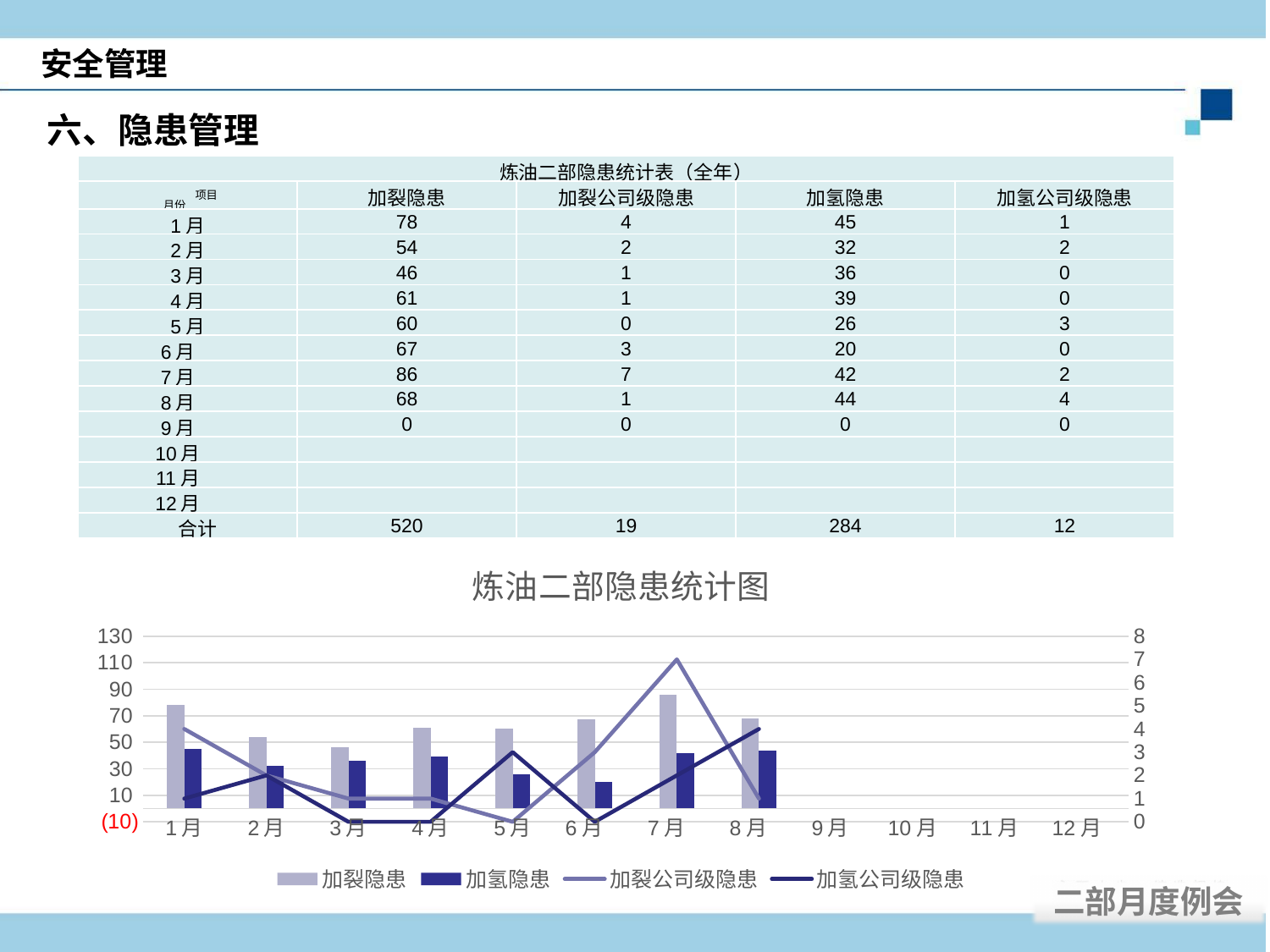
How many month categories are shown on the x axis of the chart? 12 In which month is the 加裂隐患 bar the highest? 7月 What is the title of the chart on the slide? 炼油二部隐患统计图 Is the 加氢隐患 value for 6月 greater or less than 30? less In 7月, which line is higher, 加裂公司级隐患 or 加氢公司级隐患? 加裂公司级隐患 Does the 加裂公司级隐患 line rise or fall from 6月 to 7月? rise Is the 加裂隐患 value for 7月 greater or less than 70? greater How many series does the chart legend list? 4 What is the maximum value shown on the right-hand (secondary) axis of the chart? 8 What kind of chart is shown on the slide? Combined bar and line chart In 1月, which is larger, 加裂隐患 or 加氢隐患? 加裂隐患 Is the 加裂公司级隐患 value for 7月 greater or less than 5 on the right axis? greater